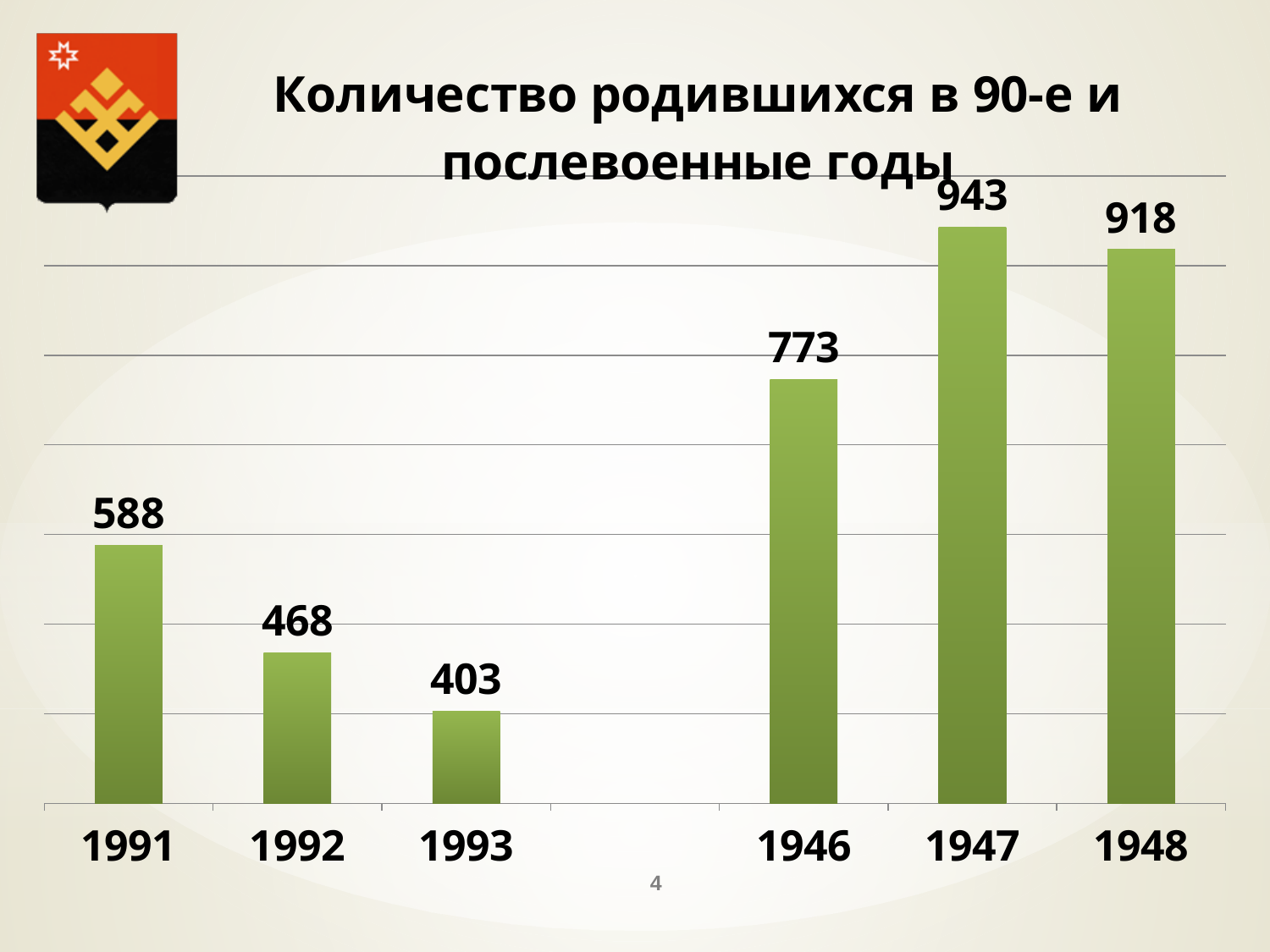
What is the difference between the values for 1991 and 1992? 120 Which year has the highest value? 1947 Do the values rise or fall from 1991 to 1993? fall Which year has the lowest value? 1993 What is the value for 1991? 588 What kind of chart is shown on the slide? bar chart How many years are shown in the chart? 6 Which is larger, the value for 1946 or the value for 1991? 1946 What is the value for 1946? 773 What is the difference between the values for 1947 and 1948? 25 What is the value for 1947? 943 What is the value for 1993? 403